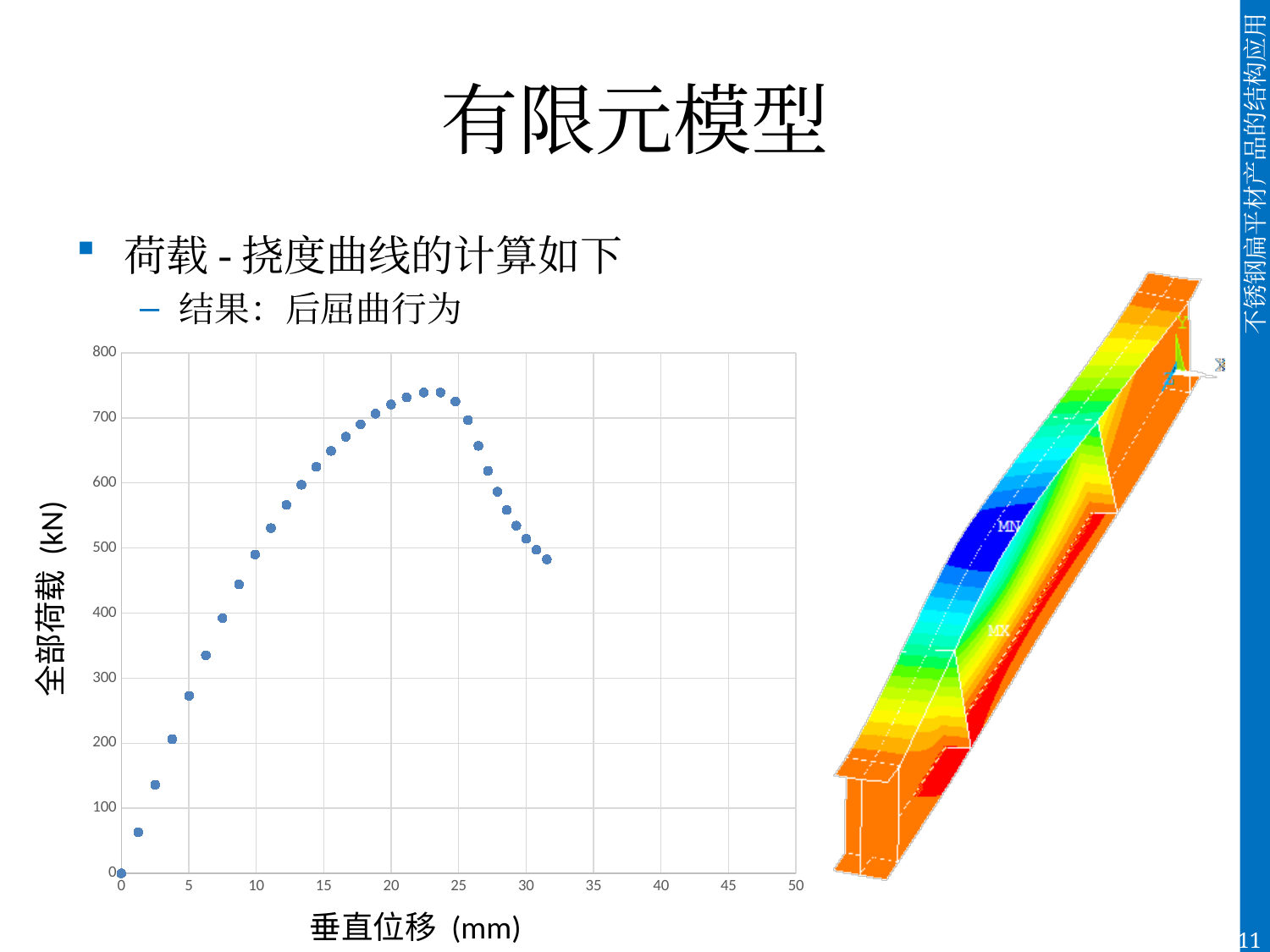
What is the label of the horizontal axis of the chart? 垂直位移 (mm) Is the load at a vertical displacement of 5 mm greater or less than 300 kN? less After the peak at about 22 mm displacement, do the load values rise or fall as displacement increases further? fall Is the load at a vertical displacement of 20 mm greater or less than 700 kN? greater What kind of chart is shown on the slide? scatter chart How does the load change as vertical displacement increases from 0 to about 22 mm? rises Is the load at a vertical displacement of 5 mm greater or less than 200 kN? greater What is the maximum value shown on the vertical axis of the chart? 800 What is the label of the vertical axis of the chart? 全部荷载 (kN)